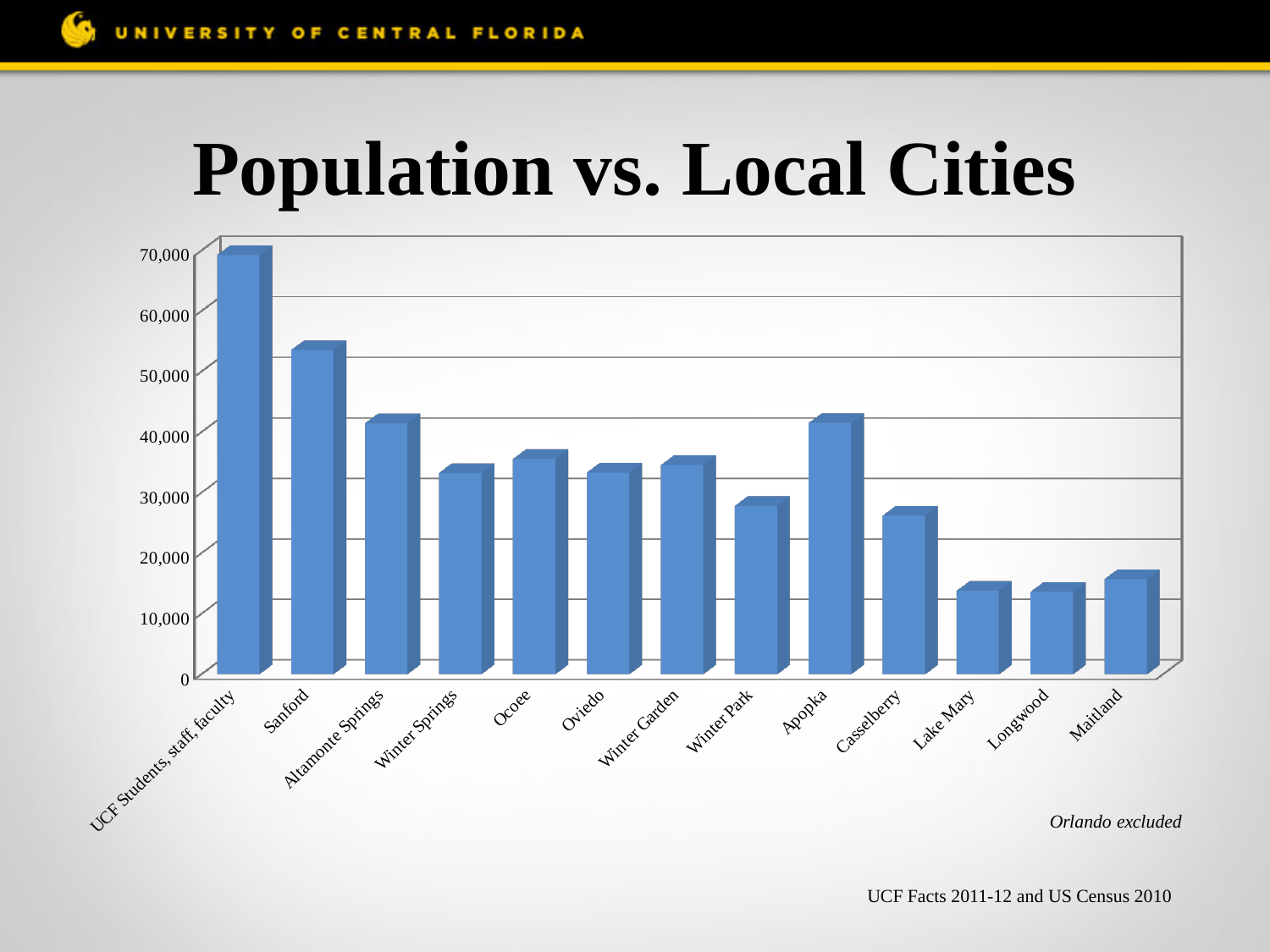
What kind of chart is shown on the slide? Bar chart Which is larger, the value for Ocoee or the value for Winter Park? Ocoee Which is larger, the value for Sanford or the value for Altamonte Springs? Sanford Is the value for Casselberry greater or less than 20,000? greater Is the value for Lake Mary greater or less than 10,000? greater Is the value for Sanford greater or less than 50,000? greater What is the title of the chart? Population vs. Local Cities How many categories are plotted on the chart? 13 Which category has the highest value on the chart? UCF Students, staff, faculty Which city does the note below the chart say is excluded? Orlando